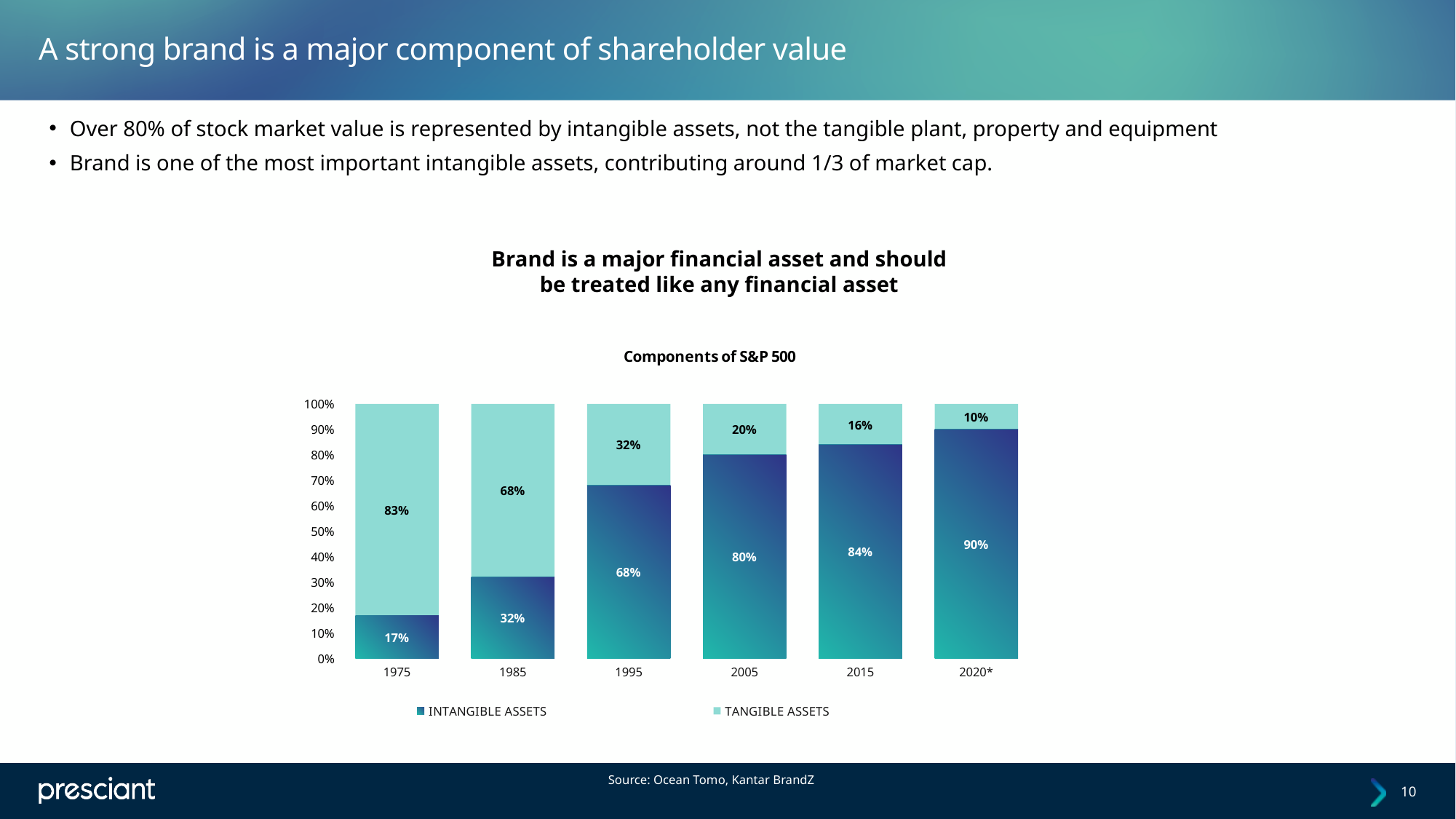
What kind of chart is shown? Stacked bar chart What is the value for Tangible Assets in 1995? 32% What is the value for Intangible Assets in 1975? 17% What is the value for Intangible Assets in 2020*? 90% What is the difference between the Intangible Assets values for 2015 and 2005? 4% How many years are shown on the x axis? 6 Which year has the lowest value for Intangible Assets? 1975 What is the title of the chart? Components of S&P 500 Which is larger: Intangible Assets in 1985 or Tangible Assets in 1985? Tangible Assets in 1985 Which year has the highest value for Tangible Assets? 1975 How many series does the legend list? 2 Do the Intangible Assets values rise or fall from 1975 to 2020*? Rise